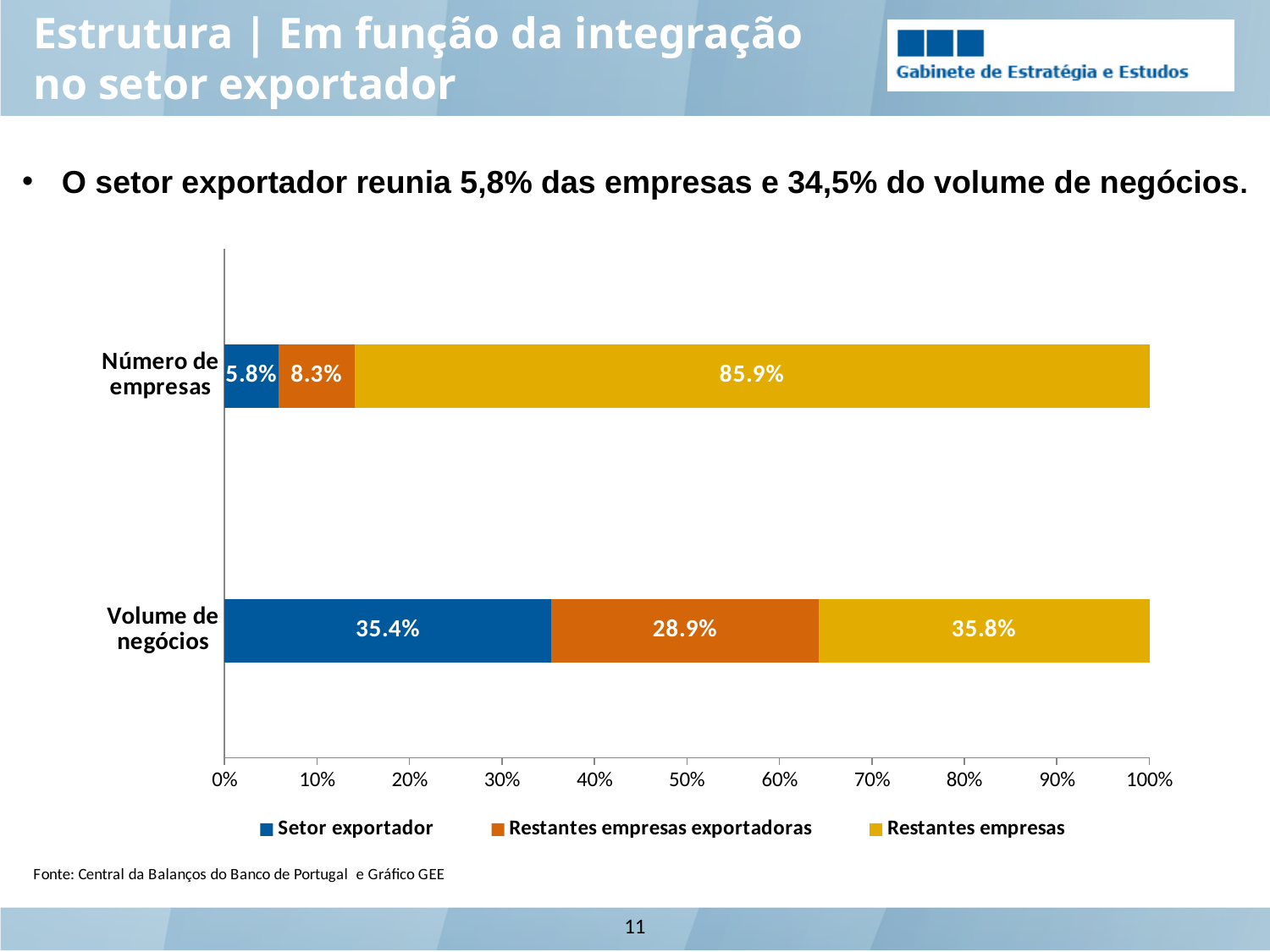
What is the difference between the Setor exportador values for Volume de negócios and Número de empresas? 29.6% What is the value of Setor exportador for Volume de negócios? 35.4% What colour represents Setor exportador in the chart? Blue Which series has the lowest value for Volume de negócios? Restantes empresas exportadoras What is the value of Restantes empresas for Número de empresas? 85.9% What is the value of Setor exportador for Número de empresas? 5.8% How many categories are shown on the chart? 2 Which series has the highest value for Número de empresas? Restantes empresas What kind of chart is shown on the slide? Stacked bar chart Which is larger: Restantes empresas exportadoras for Número de empresas or for Volume de negócios? Volume de negócios What is the value of Restantes empresas exportadoras for Volume de negócios? 28.9% How many series does the legend list? 3